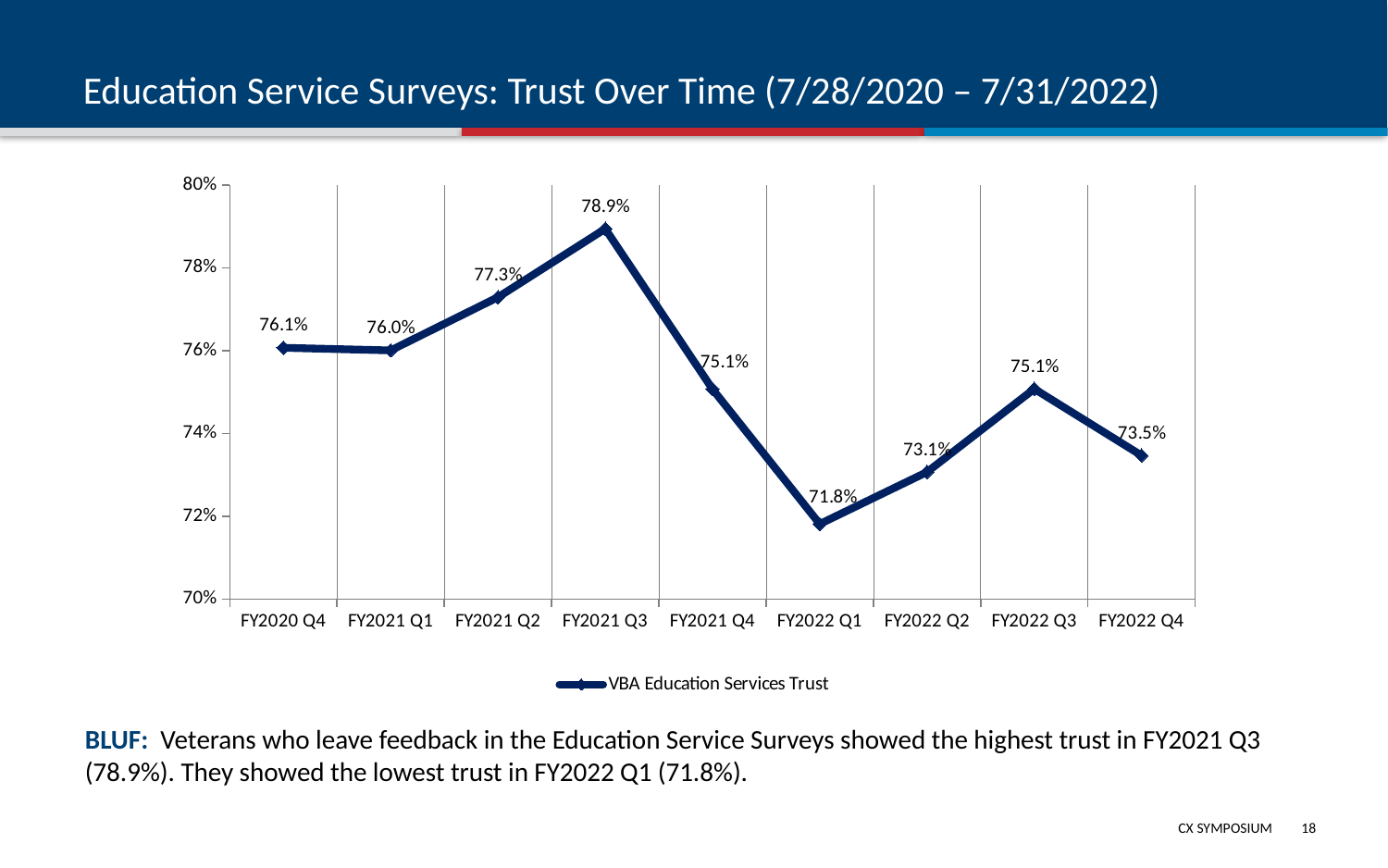
What is the difference between the trust values for FY2021 Q3 and FY2022 Q1? 7.1% How many quarters are plotted on the chart? 9 What kind of chart is shown on the slide? line chart What is the trust value for FY2020 Q4? 76.1% How many series does the legend list? 1 Which is larger, the trust value for FY2021 Q2 or FY2022 Q2? FY2021 Q2 Which quarter has the highest trust value? FY2021 Q3 Which quarter has the lowest trust value? FY2022 Q1 What is the VBA Education Services Trust value for FY2021 Q3? 78.9% What is the trust value for FY2022 Q1? 71.8% Does the trust value rise or fall from FY2021 Q3 to FY2022 Q1? fall Is the trust value for FY2022 Q4 greater or less than 74%? less